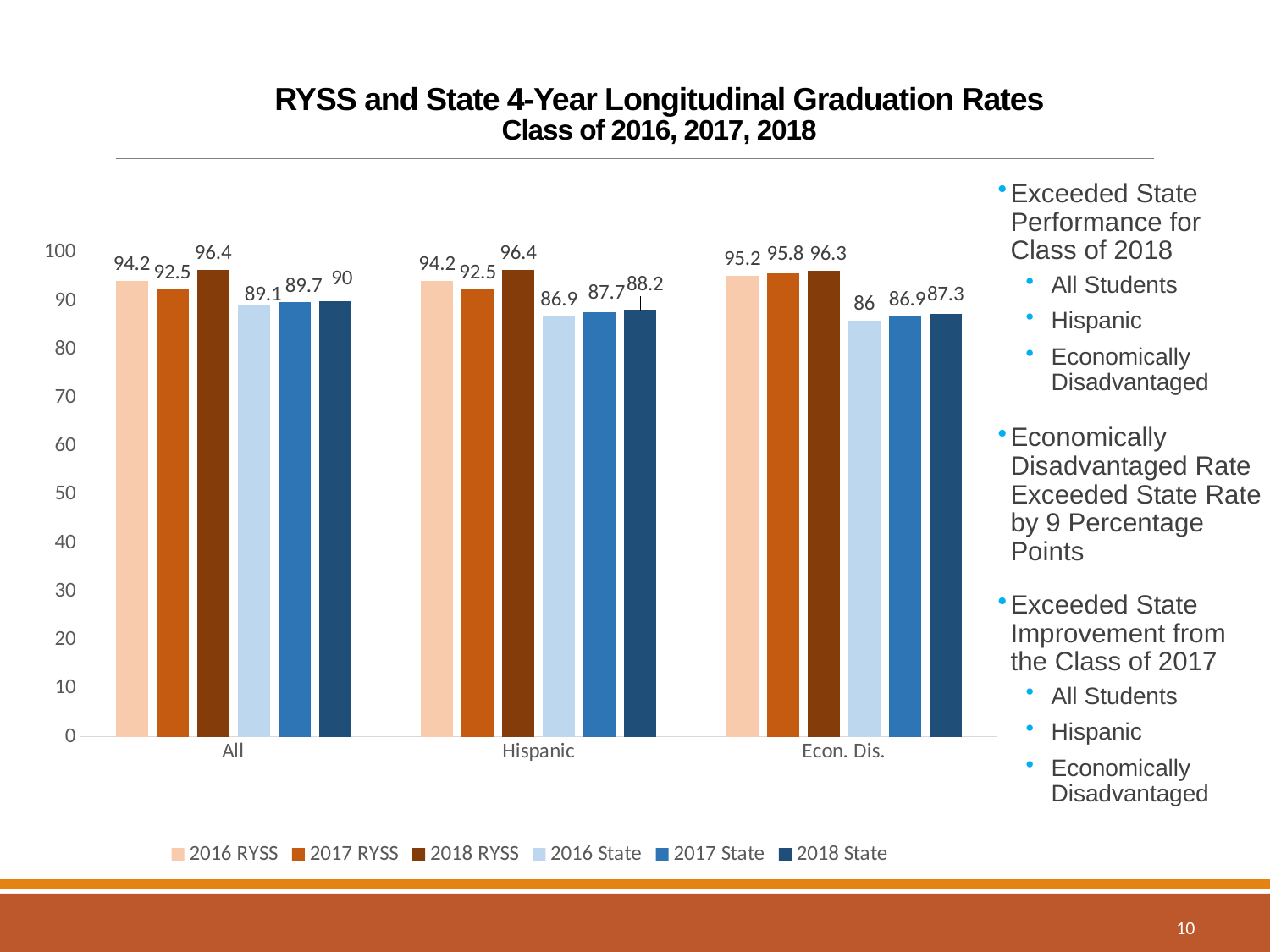
Which category has the lowest 2016 State value? Econ. Dis. How many categories are shown on the x axis? 3 What is the 2016 State graduation rate for Econ. Dis.? 86 What is the difference between the 2018 RYSS and 2018 State values for Econ. Dis.? 9 How many series does the legend list? 6 Is the 2016 State value for Hispanic greater or less than 90? less Which is larger for the All category: 2017 RYSS or 2018 State? 2017 RYSS Do the RYSS values for Econ. Dis. rise or fall from 2016 to 2018? rise Which category has the highest 2017 RYSS value? Econ. Dis. What is the 2018 RYSS graduation rate for the All category? 96.4 What is the 2017 State value for the Hispanic category? 87.7 What kind of chart is shown on the slide? bar chart